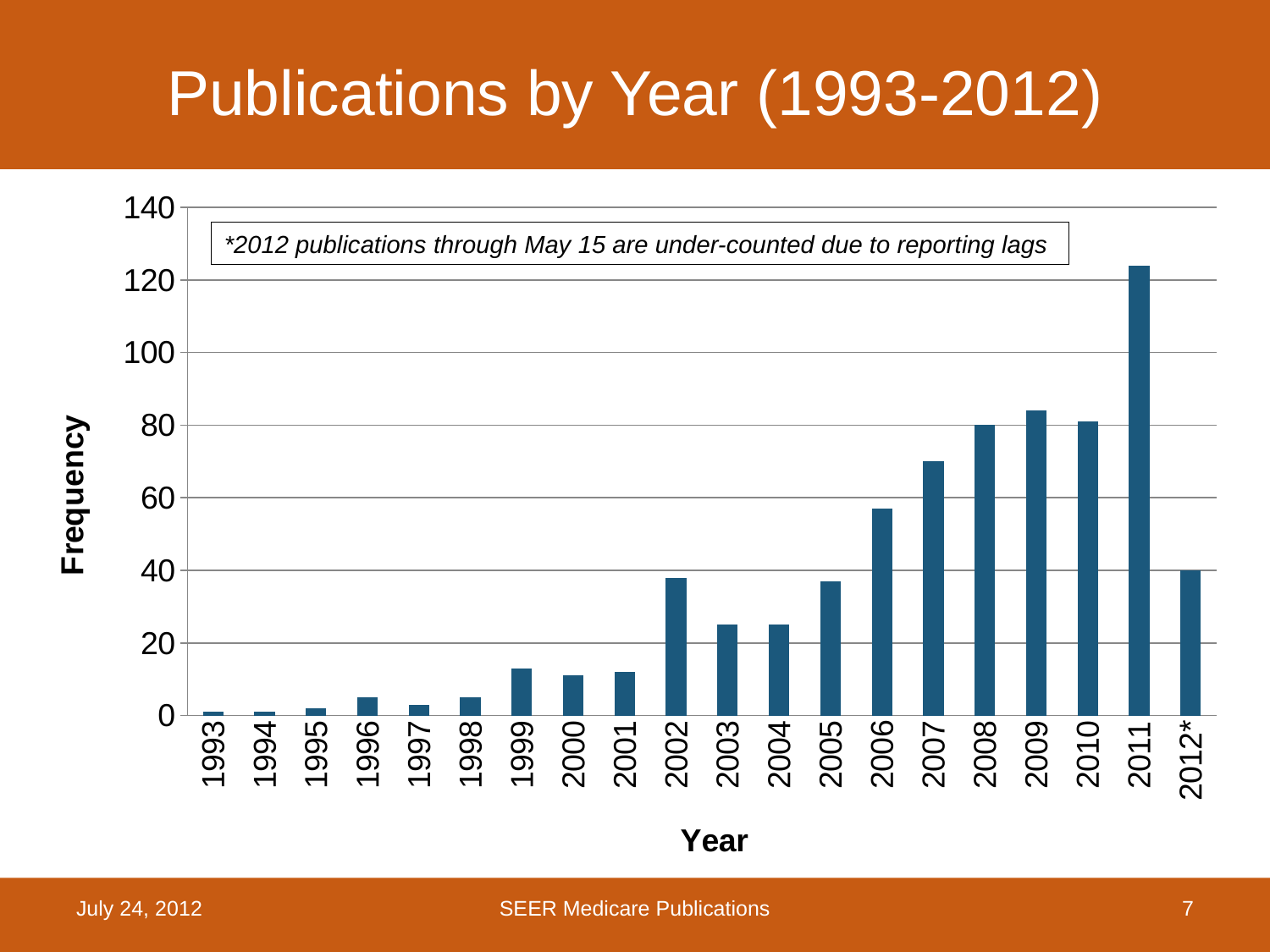
What is the title of the chart on the slide? Publications by Year (1993-2012) Which year has more publications, 2007 or 2008? 2008 What kind of chart is shown on the slide? bar chart Which year has the highest number of publications? 2011 Which year has more publications, 2002 or 2003? 2002 What is the label on the y axis of the chart? Frequency Do the publication counts generally rise or fall from 1993 to 2011? rise Is the value for 2011 greater or less than 100? greater Is the value for 2006 greater or less than 40? greater Is the value for 2005 greater or less than 40? less How many years are plotted on the x axis of the chart? 20